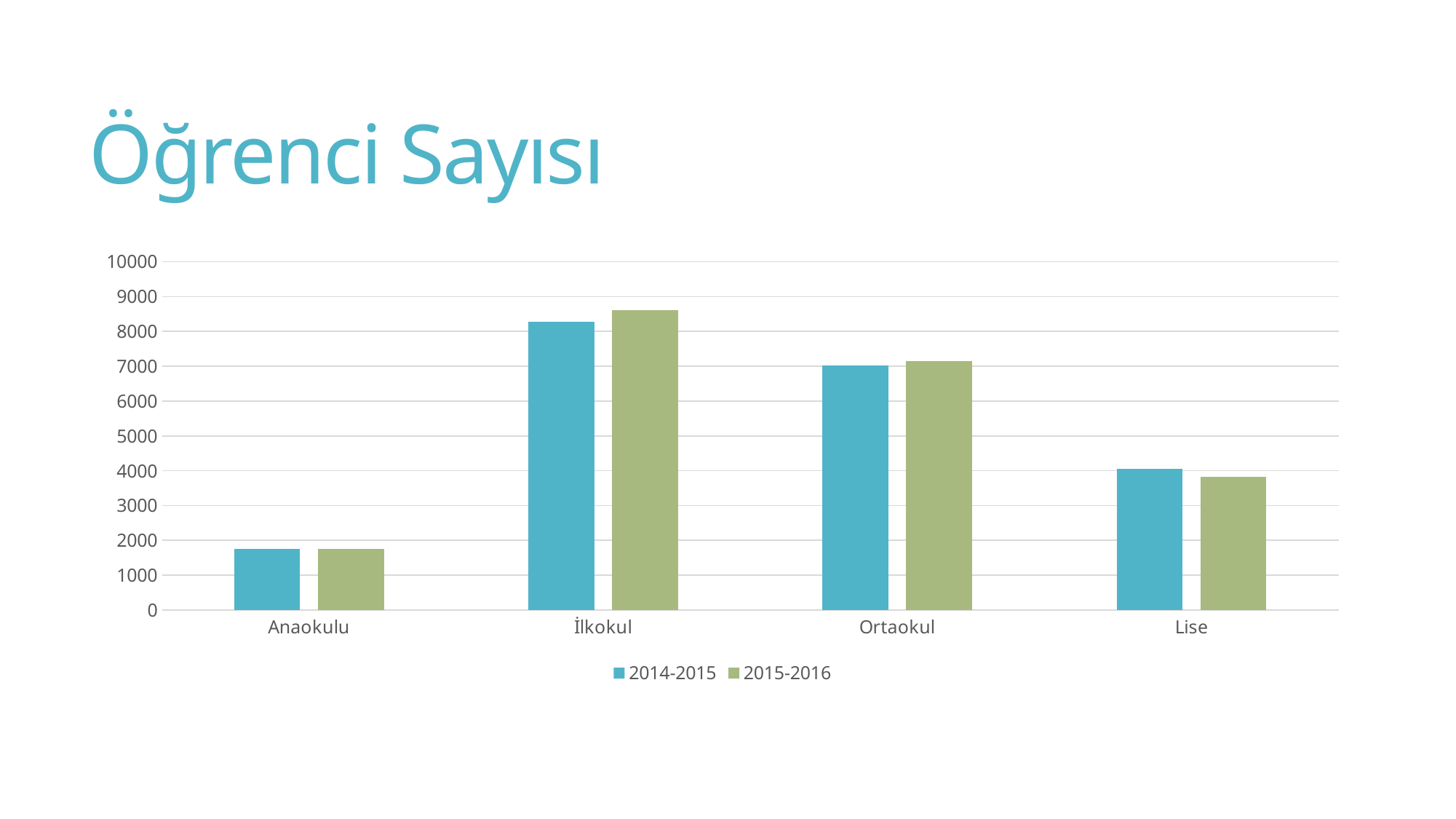
Which category has the highest value for the 2015-2016 series? İlkokul For İlkokul, which series has the larger value, 2014-2015 or 2015-2016? 2015-2016 Is the value for Lise in 2015-2016 greater or less than 3000? greater How many categories are shown on the x axis? 4 Which series is shown in green in the legend? 2015-2016 Which category has the lowest value for the 2014-2015 series? Anaokulu Is the value for Anaokulu in 2015-2016 greater or less than 2000? less Is the value for İlkokul in 2014-2015 greater or less than 8000? greater For Lise, which series has the larger value, 2014-2015 or 2015-2016? 2014-2015 What kind of chart is shown on the slide? bar chart What is the title of the chart? Öğrenci Sayısı How many series does the legend list? 2